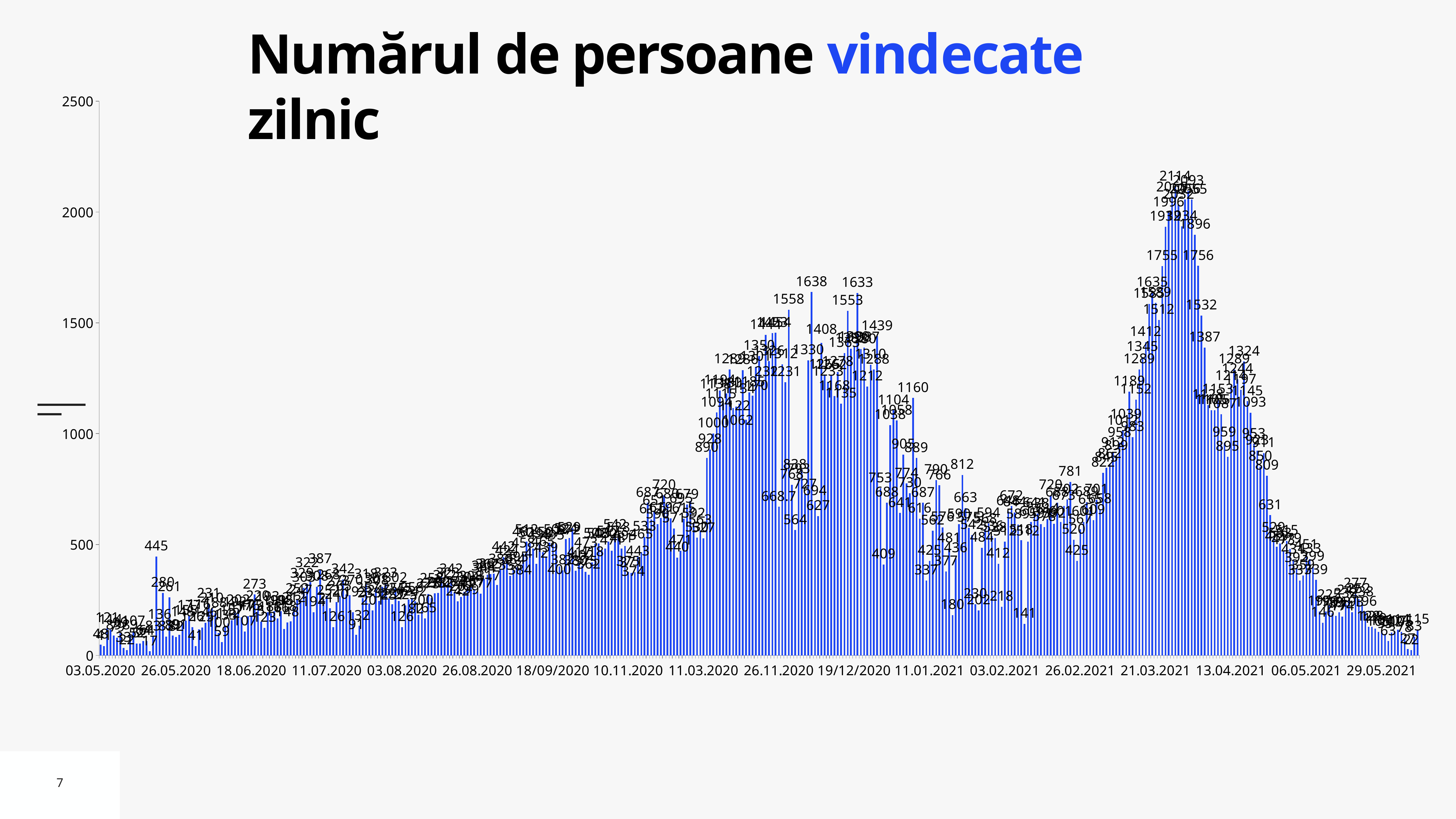
What is the difference between the bars labelled 1756 and 1755 in the spring 2021 wave? 1 Is the bar labelled 445 near 26.05.2020 greater or less than 500? less What kind of chart is shown on the slide? bar chart What is the title of the chart? Numărul de persoane vindecate zilnic What is the value of the tallest bar in the first wave, near 26.05.2020? 445 Of the two peaks labelled 1638 and 1633 in the late-2020 wave, which is higher? 1638 What is the first date label shown on the x axis? 03.05.2020 Do the values rise or fall along the x axis from 21.03.2021 to 29.05.2021? fall Are the bars at the far right of the chart, around 29.05.2021, greater or less than 500? less Is the tallest bar on the chart greater or less than 2000? greater What is the difference between the peaks labelled 1638 and 1633? 5 What is the highest value labelled on the chart? 2114